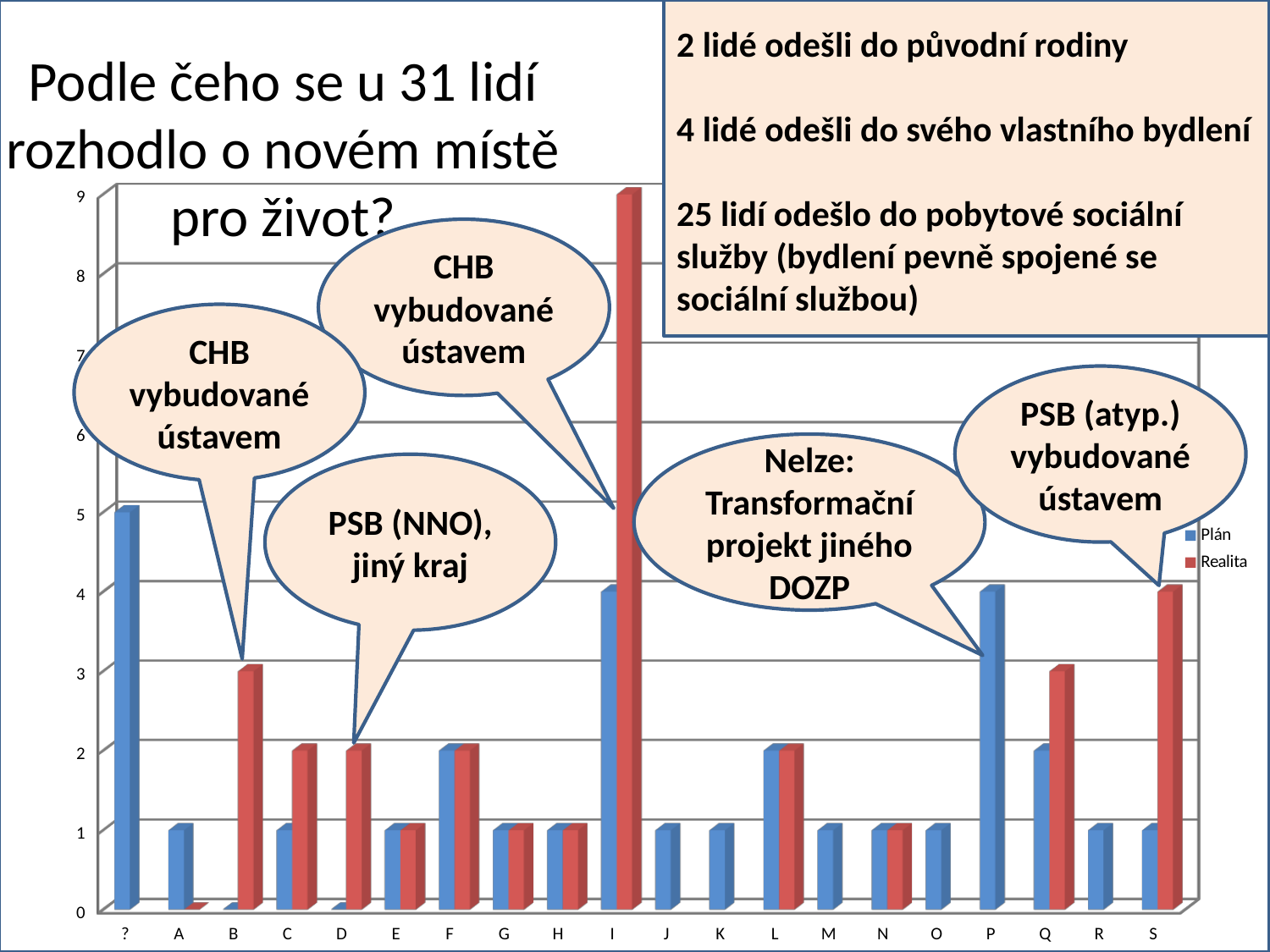
What is the Plán value for category P? 4 How many categories are shown along the x axis of the chart? 20 What is the Plán value for category ? 5 Is the Realita value for category I greater or less than 8? greater What is the difference between the Realita and Plán values for category I? 5 What is the Realita value for category I? 9 What is the Realita value for category S? 4 What are the two series named in the chart legend? Plán and Realita How many series does the chart legend list? 2 What kind of chart is shown on the slide? bar chart Which category has the highest Realita value? I For category I, which is larger, Plán or Realita? Realita